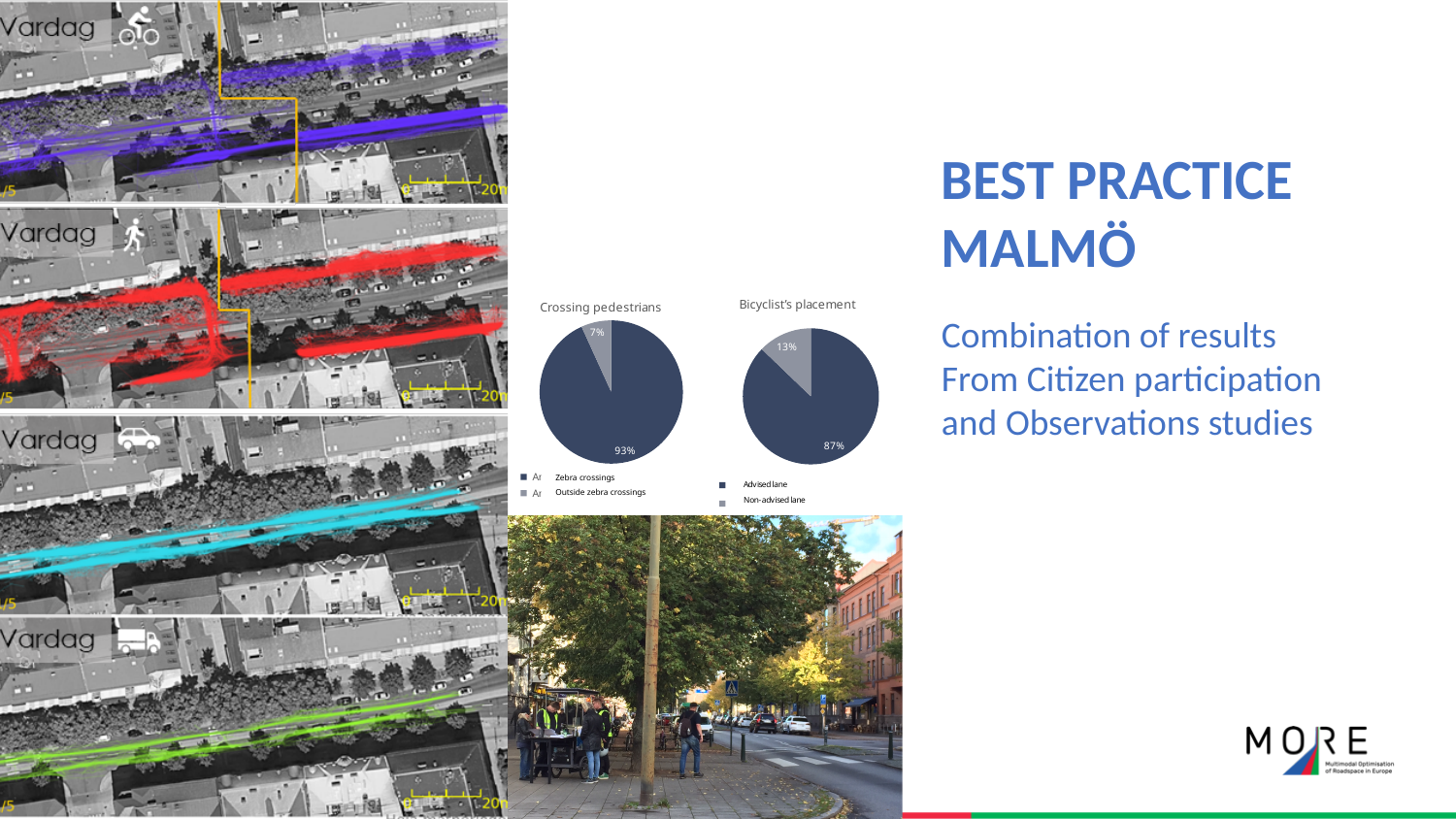
In the 'Crossing pedestrians' chart, what is the difference in percentage points between zebra crossings and outside zebra crossings? 86 percentage points In the 'Crossing pedestrians' chart, what share of pedestrians crossed outside zebra crossings? 7% In the 'Bicyclist's placement' chart, what share of bicyclists used the advised lane? 87% In the 'Crossing pedestrians' chart, which category has the largest slice? Zebra crossings How many slices does the 'Bicyclist's placement' pie chart have? 2 In the 'Crossing pedestrians' chart, what share of pedestrians crossed at zebra crossings? 93% What kind of chart is the 'Crossing pedestrians' chart? Pie chart In the 'Bicyclist's placement' chart, which category has the smallest slice? Non-advised lane In the 'Bicyclist's placement' chart, what share of bicyclists used the non-advised lane? 13% Which is larger: the zebra crossings share in the 'Crossing pedestrians' chart or the advised lane share in the 'Bicyclist's placement' chart? Zebra crossings (93%) How many pie charts are shown on the slide? 2 In the 'Bicyclist's placement' chart, what is the difference in percentage points between the advised lane and the non-advised lane? 74 percentage points